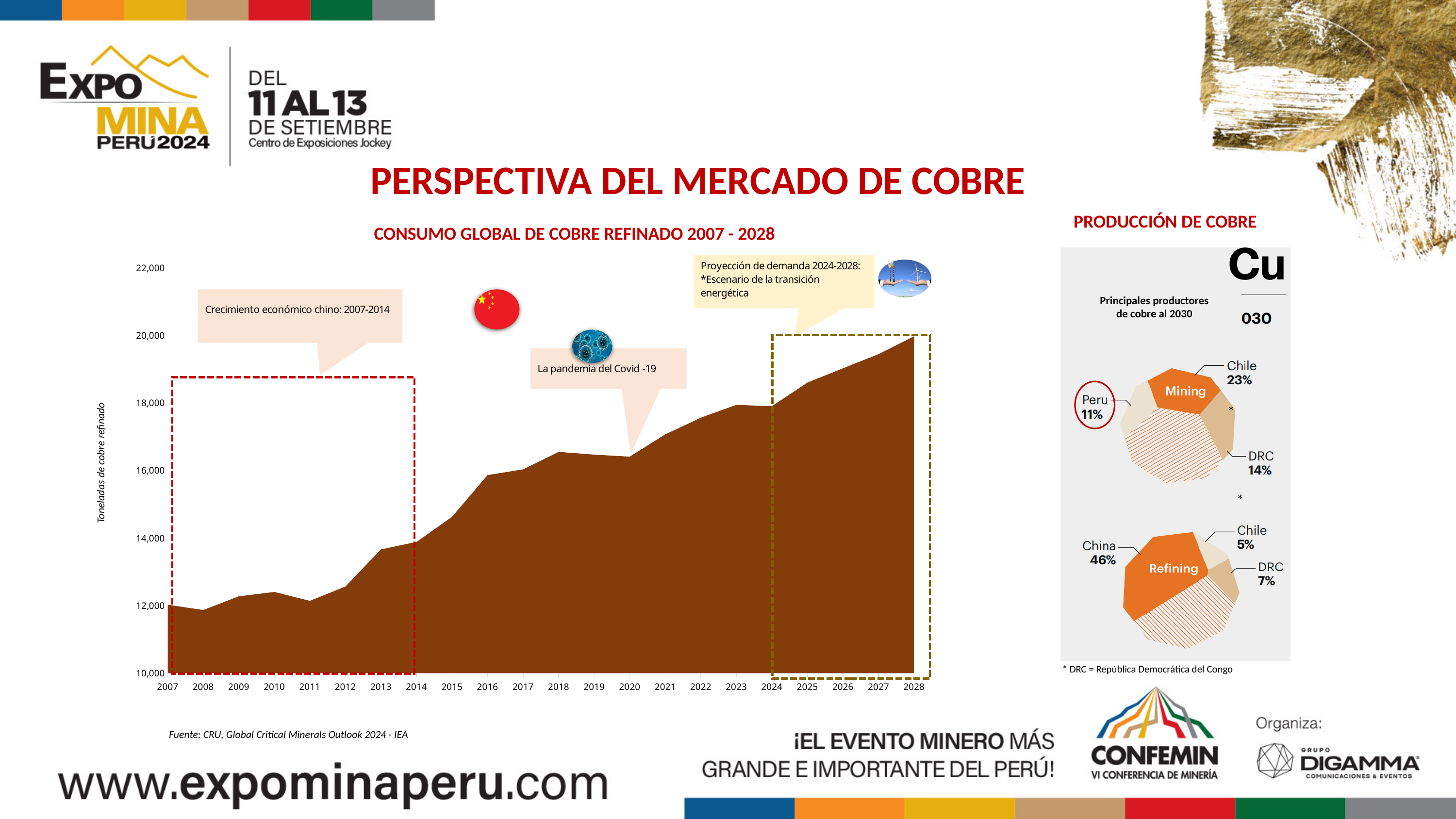
What kind of chart is the 'CONSUMO GLOBAL DE COBRE REFINADO 2007 - 2028' chart? Area chart In the 'PRODUCCIÓN DE COBRE' graphic on the right, what share of copper mining is attributed to Chile? 23% In the 'CONSUMO GLOBAL DE COBRE REFINADO 2007 - 2028' chart, how many years are shown on the x axis? 22 In the 'CONSUMO GLOBAL DE COBRE REFINADO 2007 - 2028' chart, is the value for 2025 greater or less than 18,000? greater In the 'PRODUCCIÓN DE COBRE' graphic on the right, what share of copper refining is attributed to China? 46% In the 'CONSUMO GLOBAL DE COBRE REFINADO 2007 - 2028' chart, is the value for 2020 greater or less than 16,000? greater In the 'CONSUMO GLOBAL DE COBRE REFINADO 2007 - 2028' chart, do the values generally rise or fall from 2007 to 2028? Rise What is the y-axis label of the 'CONSUMO GLOBAL DE COBRE REFINADO 2007 - 2028' chart? Toneladas de cobre refinado What is the title of the chart on the left side of the slide? CONSUMO GLOBAL DE COBRE REFINADO 2007 - 2028 In the 'CONSUMO GLOBAL DE COBRE REFINADO 2007 - 2028' chart, which year has the highest value? 2028 In the 'CONSUMO GLOBAL DE COBRE REFINADO 2007 - 2028' chart, which is larger, the value for 2028 or the value for 2007? 2028 In the 'CONSUMO GLOBAL DE COBRE REFINADO 2007 - 2028' chart, is the value for 2013 greater or less than 14,000? less